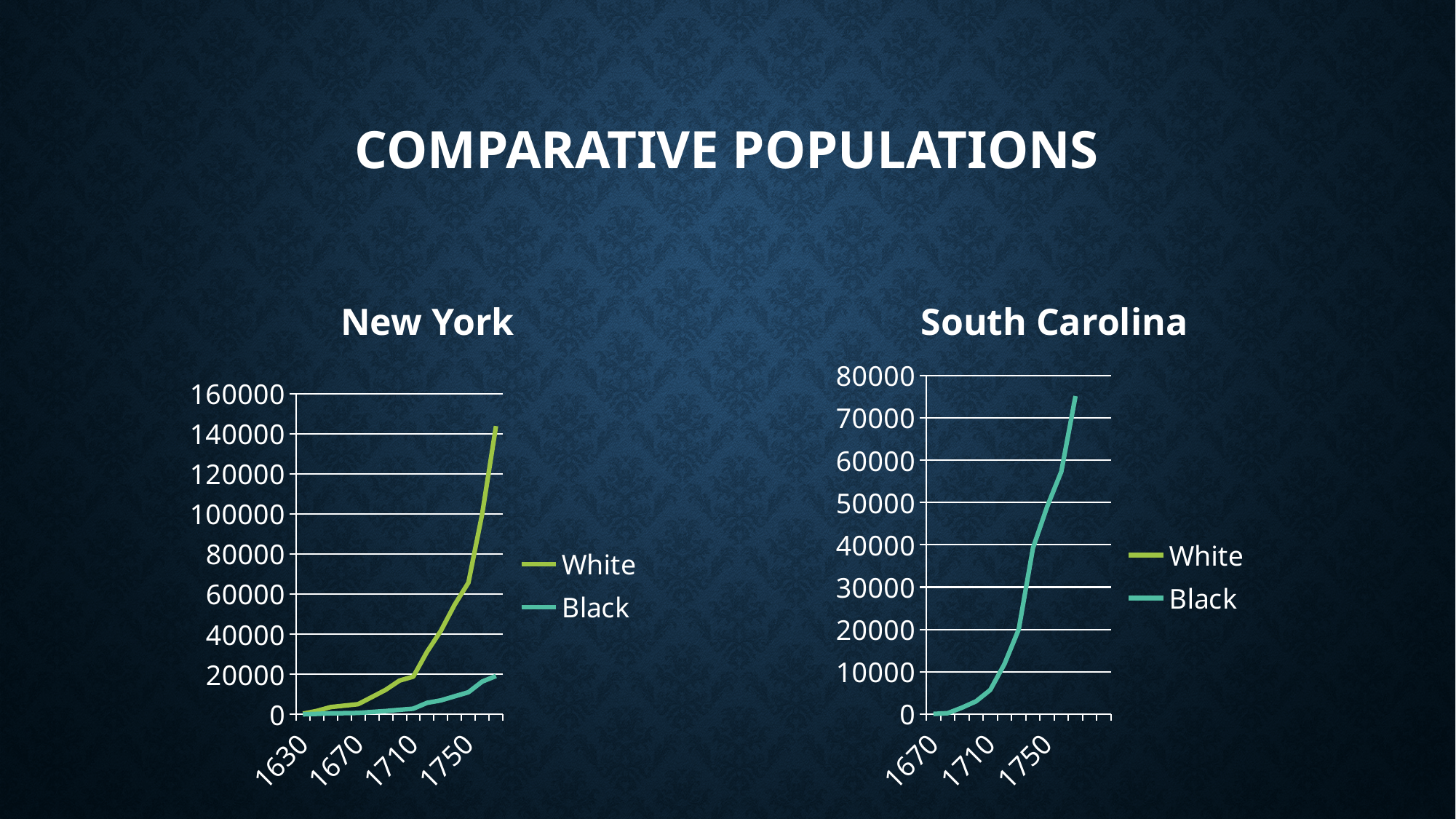
What kind of chart is the New York chart? line chart In the New York chart, at the final year plotted, is the Black value greater or less than 10000? greater How many series does the legend of the New York chart list? 2 In the South Carolina chart, at 1710, is the Black value greater or less than 10000? less In the New York chart, which series reaches the highest value? White In the New York chart, does the White population rise or fall over time along the x axis? rise In the New York chart, at the final year plotted, which series has the larger value, White or Black? White In the South Carolina chart, at the final year plotted, is the Black value greater or less than 70000? greater How many series does the legend of the South Carolina chart list? 2 In the South Carolina chart, does the Black population rise or fall over time along the x axis? rise What kind of chart is the South Carolina chart? line chart